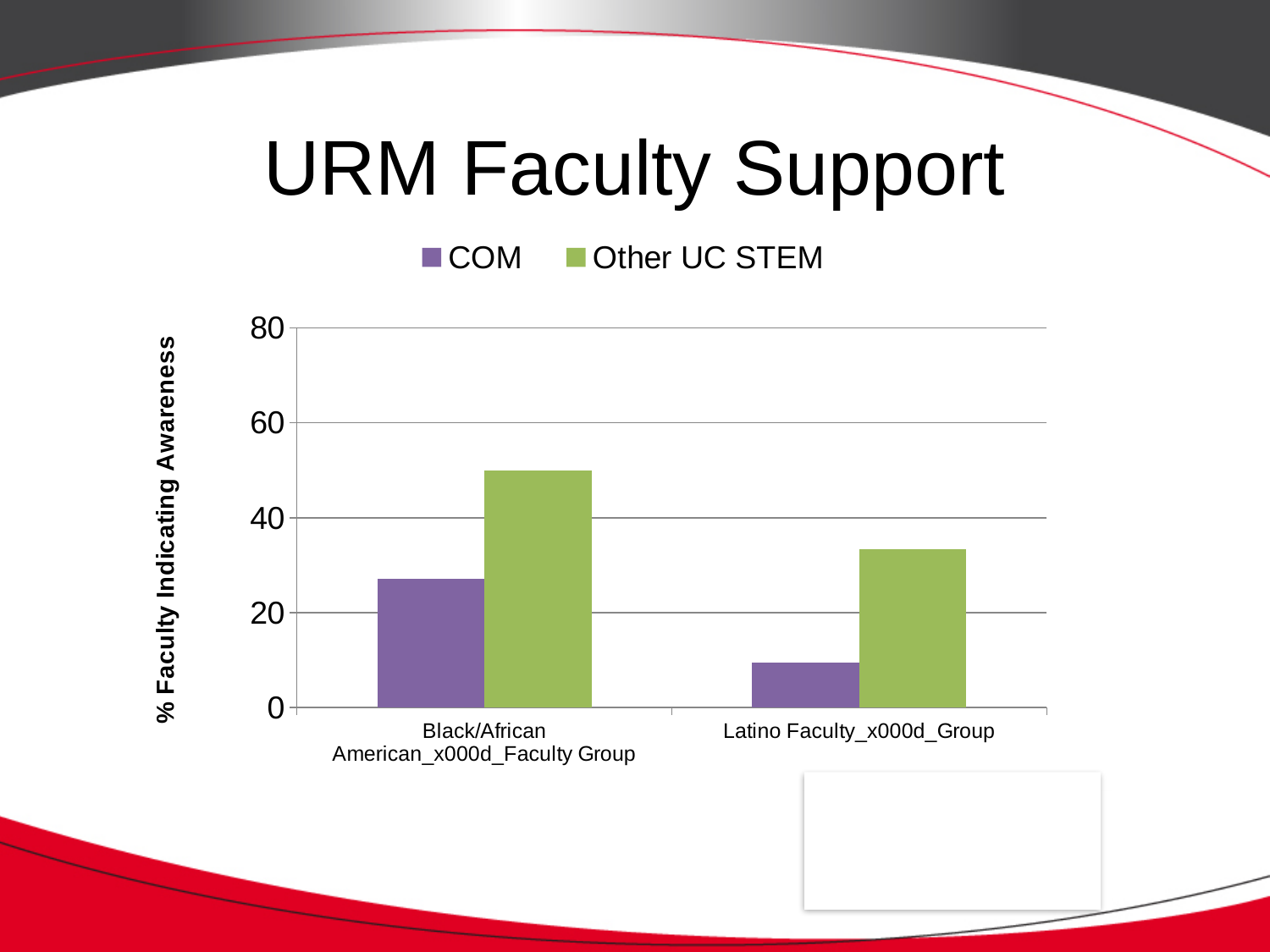
Which bar in the chart is the tallest? Other UC STEM for the Black/African American Faculty Group Which bar in the chart is the shortest? COM for the Latino Faculty Group For the Latino Faculty Group, which series has the larger value, COM or Other UC STEM? Other UC STEM Is the Other UC STEM value for the Latino Faculty Group greater or less than 20? greater Is the Other UC STEM value for the Black/African American Faculty Group greater or less than 40? greater How many series does the legend list? 2 How many faculty group categories are shown on the x axis? 2 Is the COM value for the Latino Faculty Group greater or less than 20? less What is the label on the vertical axis? % Faculty Indicating Awareness What is the title of the chart? URM Faculty Support What kind of chart is shown on the slide? bar chart